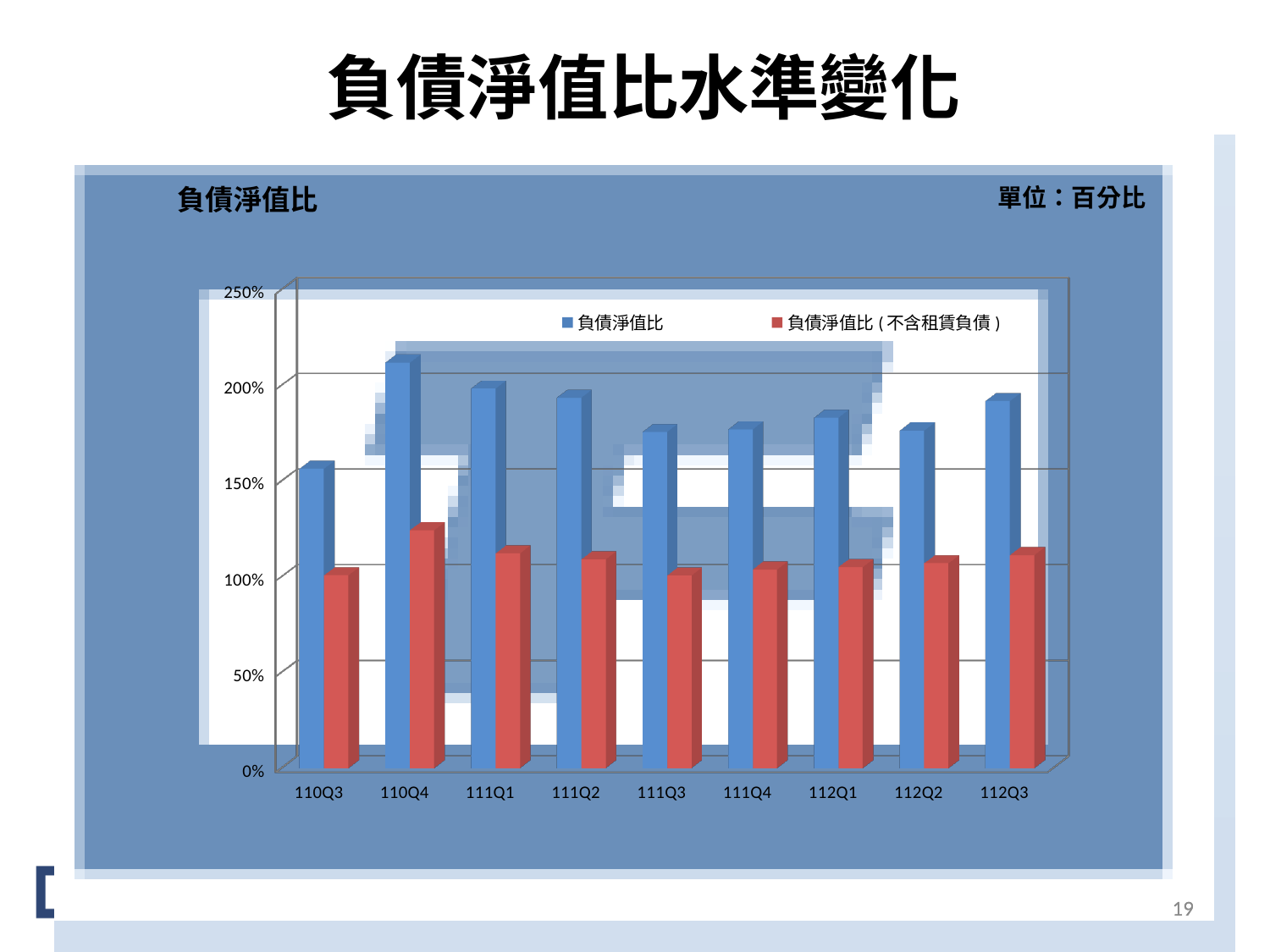
How many quarters are shown on the x axis? 9 Is the 負債淨值比 (blue series) for 110Q4 greater or less than 200%? greater Which quarter has the highest 負債淨值比(不含租賃負債) (red series)? 110Q4 Which quarter has the highest 負債淨值比 (blue series)? 110Q4 Is the 負債淨值比 (blue series) for 111Q3 greater or less than 200%? less Which quarter has the lowest 負債淨值比 (blue series)? 110Q3 Is the 負債淨值比(不含租賃負債) (red series) for 110Q4 greater or less than 100%? greater Which quarter has a larger 負債淨值比 (blue series): 110Q3 or 110Q4? 110Q4 How many series does the legend list? 2 Which is larger in 112Q3: 負債淨值比 or 負債淨值比(不含租賃負債)? 負債淨值比 What unit is stated at the top right of the chart area? 百分比 What kind of chart is shown on the slide? bar chart